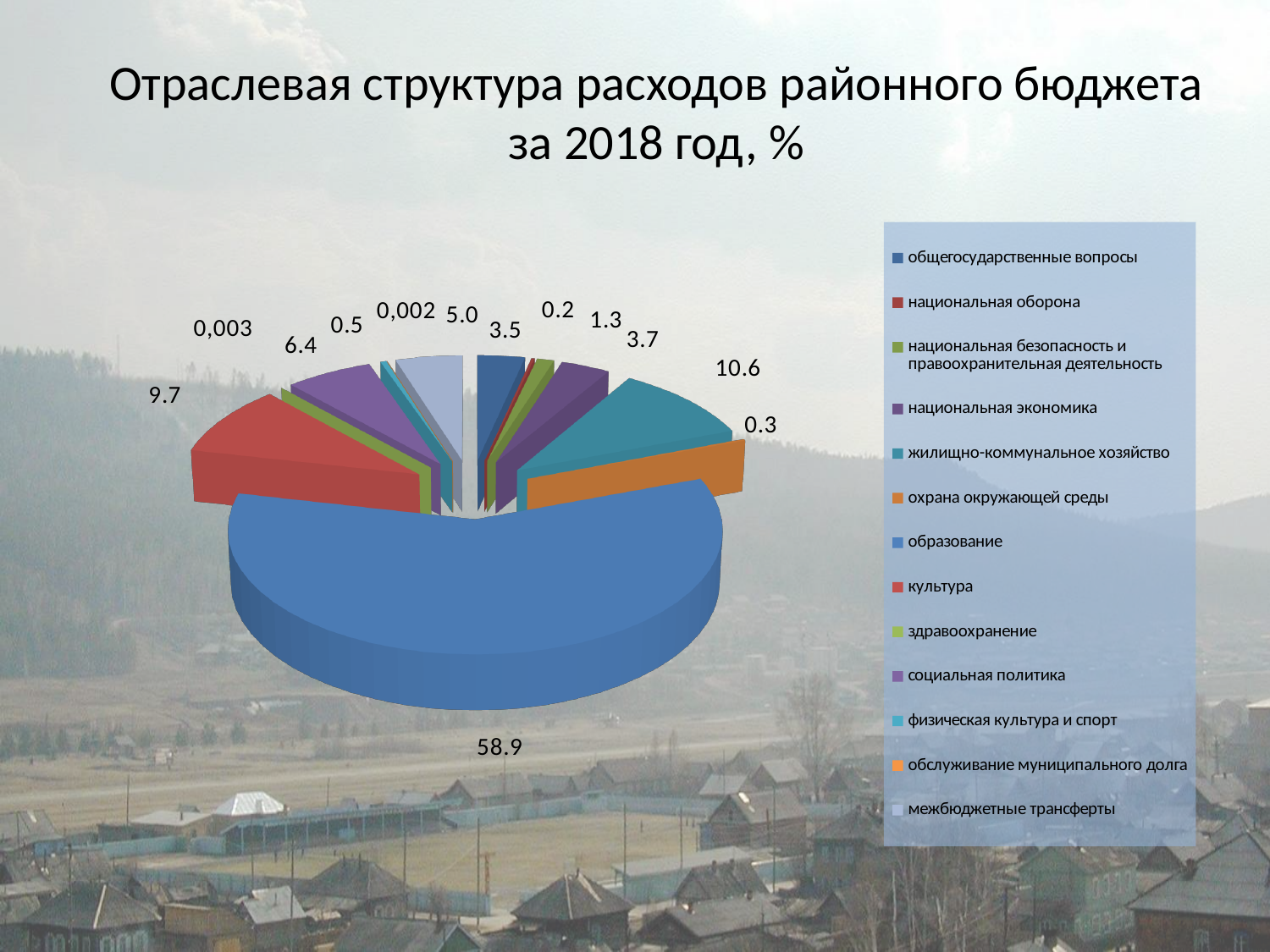
What colour is the slice for образование? blue What is the value for образование? 58.9 What kind of chart is shown on the slide? pie chart What is the difference between the values for жилищно-коммунальное хозяйство and культура? 0.9 Which category has the largest share of the pie? образование What is the value for культура? 9.7 What is the value for социальная политика? 6.4 What is the value for жилищно-коммунальное хозяйство? 10.6 How many categories does the legend list? 13 Which is larger, the value for национальная экономика or the value for общегосударственные вопросы? национальная экономика What is the value for межбюджетные трансферты? 5.0 What is the title of the chart? Отраслевая структура расходов районного бюджета за 2018 год, %